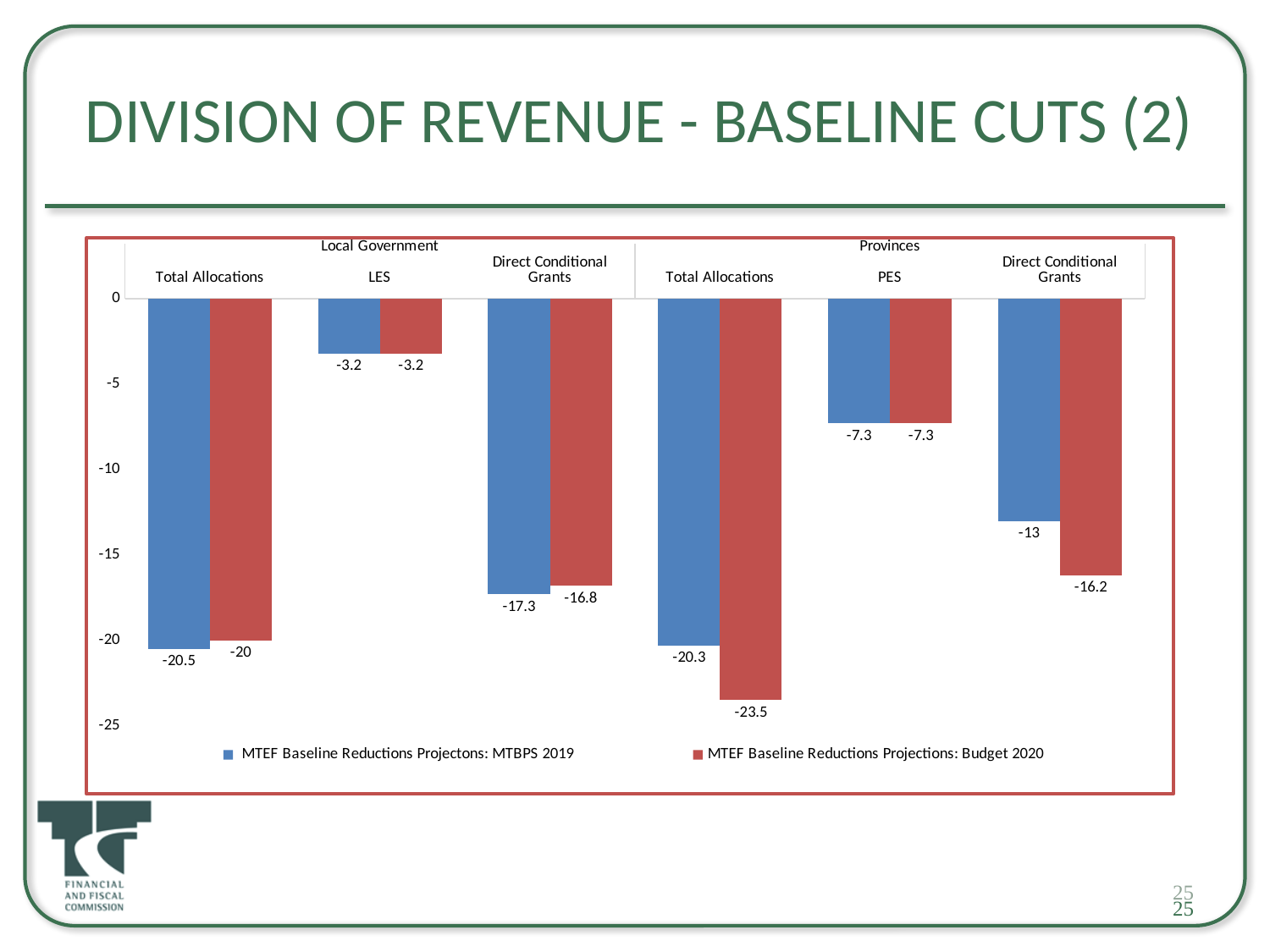
What is the difference between the MTBPS 2019 and Budget 2020 values for Provinces Direct Conditional Grants? 3.2 What is the Budget 2020 value for Provinces Total Allocations? -23.5 Which is more negative: the Budget 2020 value for Local Government Total Allocations or for Provinces Total Allocations? Provinces Total Allocations What is the Budget 2020 value for Provinces Direct Conditional Grants? -16.2 What is the difference between the MTBPS 2019 and Budget 2020 values for Provinces Total Allocations? 3.2 What is the value for PES in both series? -7.3 What is the MTBPS 2019 value for Local Government Total Allocations? -20.5 What type of chart is shown on the slide? Bar chart How many series does the legend list? 2 Which category has the value closest to zero in the MTBPS 2019 series? LES Which category has the most negative Budget 2020 value? Provinces Total Allocations What is the MTBPS 2019 value for Local Government Direct Conditional Grants? -17.3